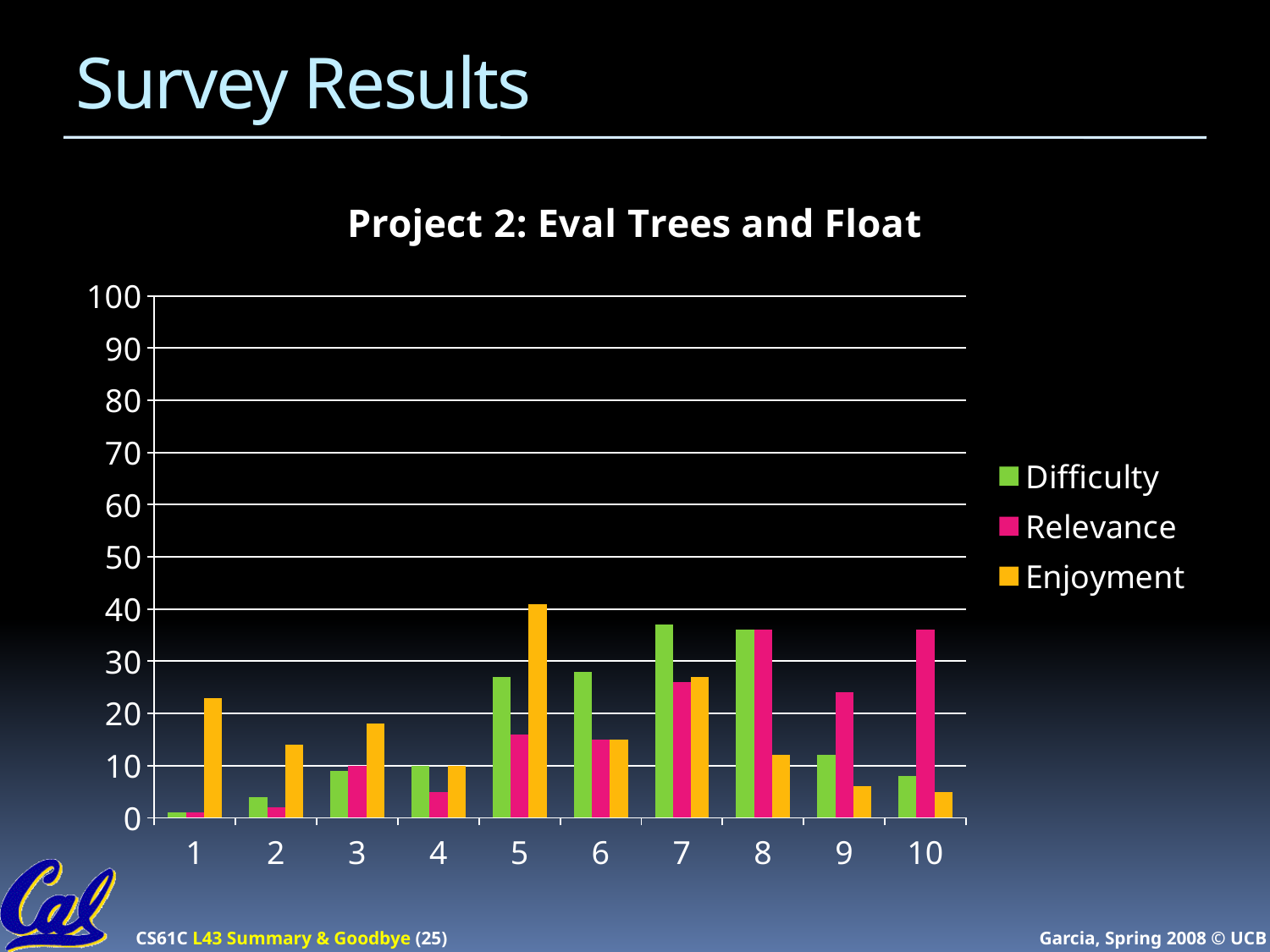
How many series does the legend list? 3 Which category has the highest Enjoyment value? 5 At category 10, which is larger: Relevance or Enjoyment? Relevance At category 1, which is larger: Enjoyment or Difficulty? Enjoyment Which category has the lowest Difficulty value? 1 Which series is shown in orange in the legend? Enjoyment Is the Difficulty value for category 1 greater or less than 10? less What is the title of the chart? Project 2: Eval Trees and Float Is the Relevance value for category 10 greater or less than 30? greater What kind of chart is shown on the slide? bar chart How many categories are shown along the x axis? 10 Is the Enjoyment value for category 5 greater or less than 30? greater